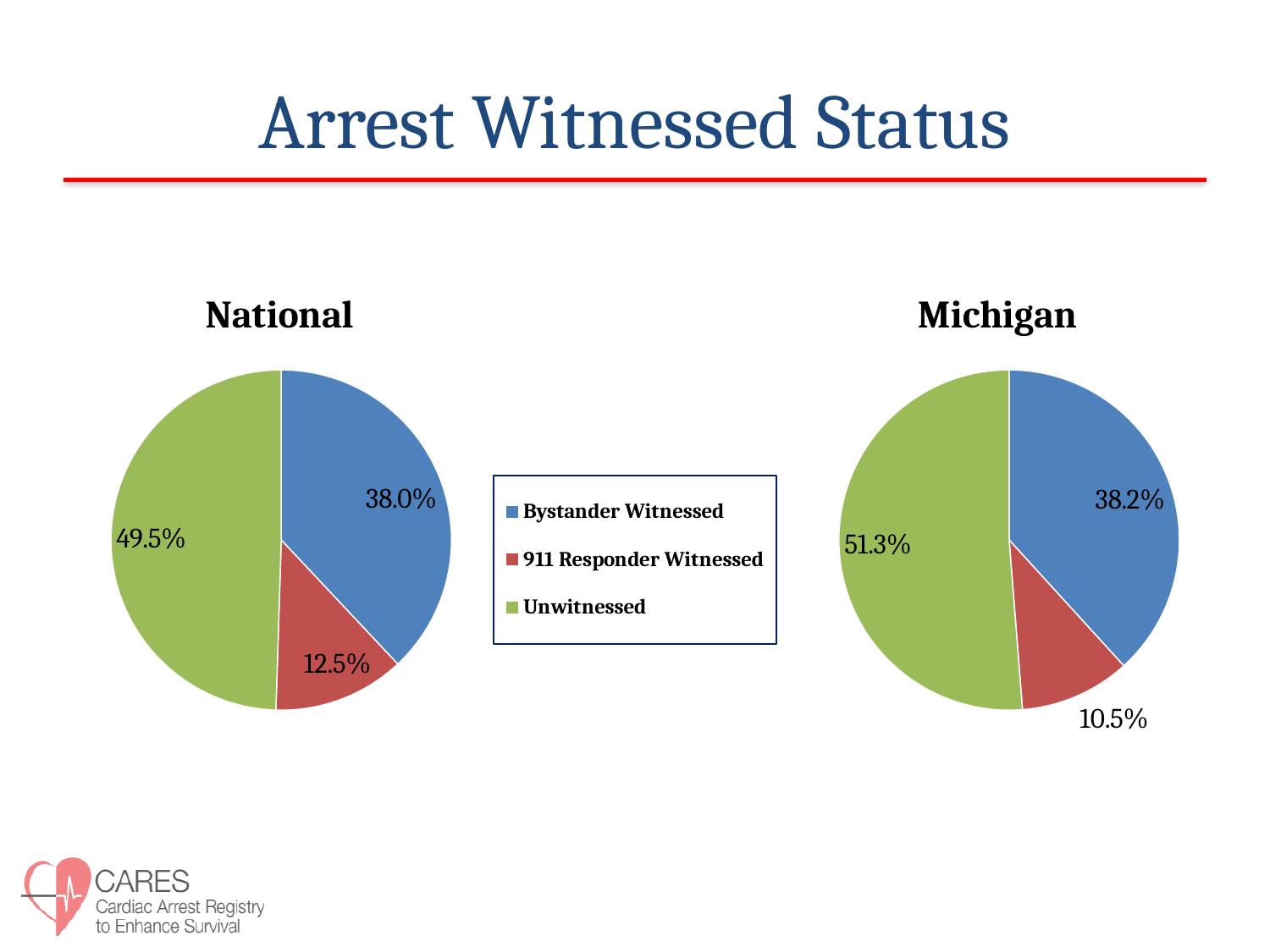
In the National pie chart, which category has the largest share? Unwitnessed In the Michigan pie chart, what percentage is 911 Responder Witnessed? 10.5% In the National pie chart, what is the difference between the Unwitnessed and Bystander Witnessed shares? 11.5% In the National pie chart, what percentage is 911 Responder Witnessed? 12.5% What is the difference between the Unwitnessed share in the Michigan chart and the Unwitnessed share in the National chart? 1.8% Which colour represents Unwitnessed in the legend? Green In the Michigan pie chart, which category has the smallest share? 911 Responder Witnessed How many slices does the Michigan pie chart have? 3 In the Michigan pie chart, what percentage is Unwitnessed? 51.3% What type of chart is used for the National data? Pie chart Is the 911 Responder Witnessed share larger in the National chart or the Michigan chart? National In the National pie chart, what percentage is Bystander Witnessed? 38.0%